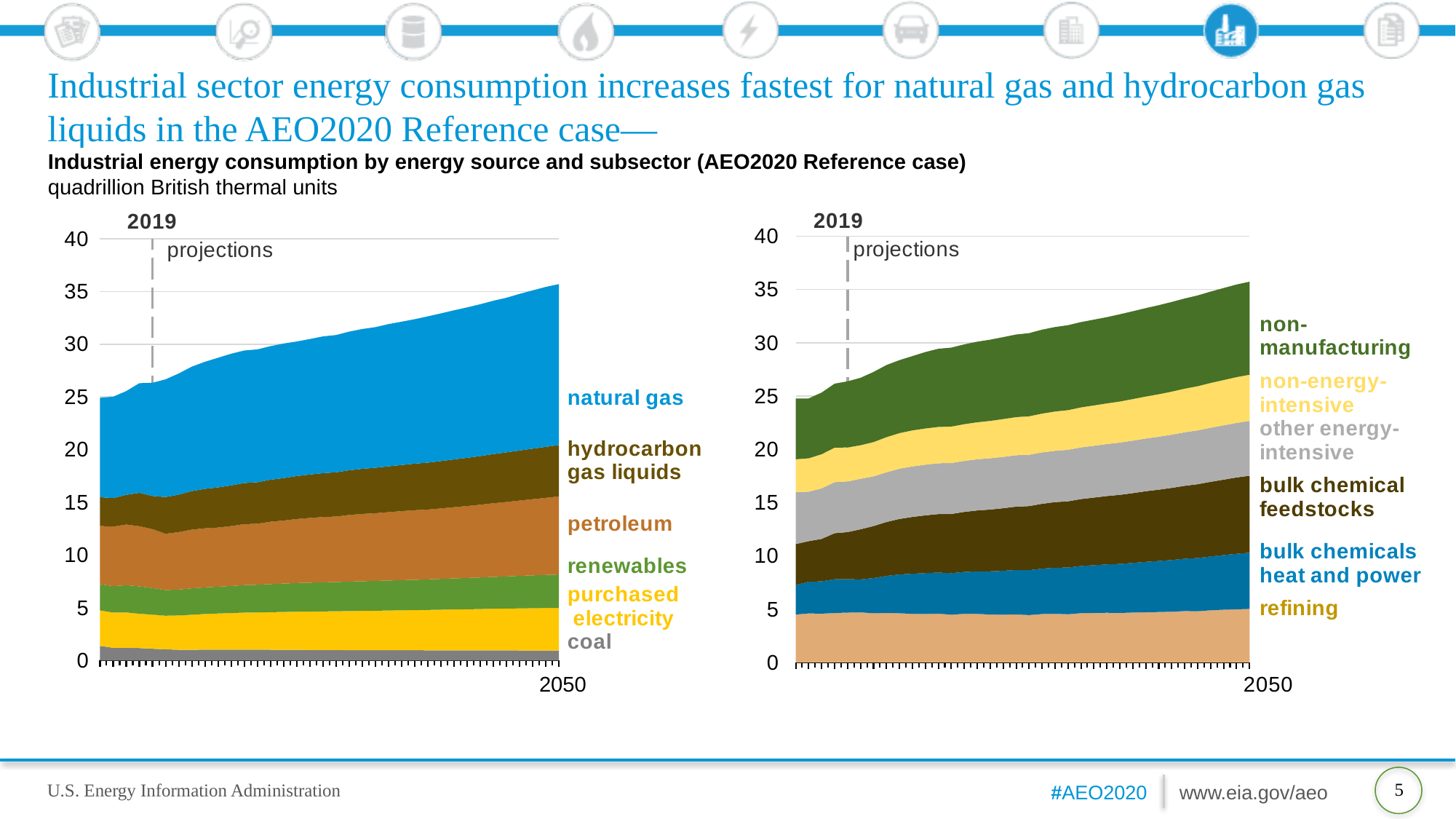
In what units are the values on both charts measured? quadrillion British thermal units What kind of chart is the left chart, 'Industrial energy consumption by energy source'? stacked area chart How many energy sources are shown as series in the left chart? 6 In the left chart, which energy source has the smallest consumption in 2050? coal In the left chart, which energy source has the largest consumption in 2050? natural gas In the left chart, is the natural gas consumption in 2050 greater or less than 10? greater In the left chart, which is larger in 2050: natural gas or petroleum? natural gas In which year do the projections begin on both charts? 2019 In the right chart, does total industrial energy consumption rise or fall from 2019 to 2050? rise In the left chart, is the total industrial energy consumption in 2050 greater or less than 30? greater How many subsectors are shown as series in the right chart? 6 In the left chart, is the total industrial energy consumption in 2019 greater or less than 25? greater